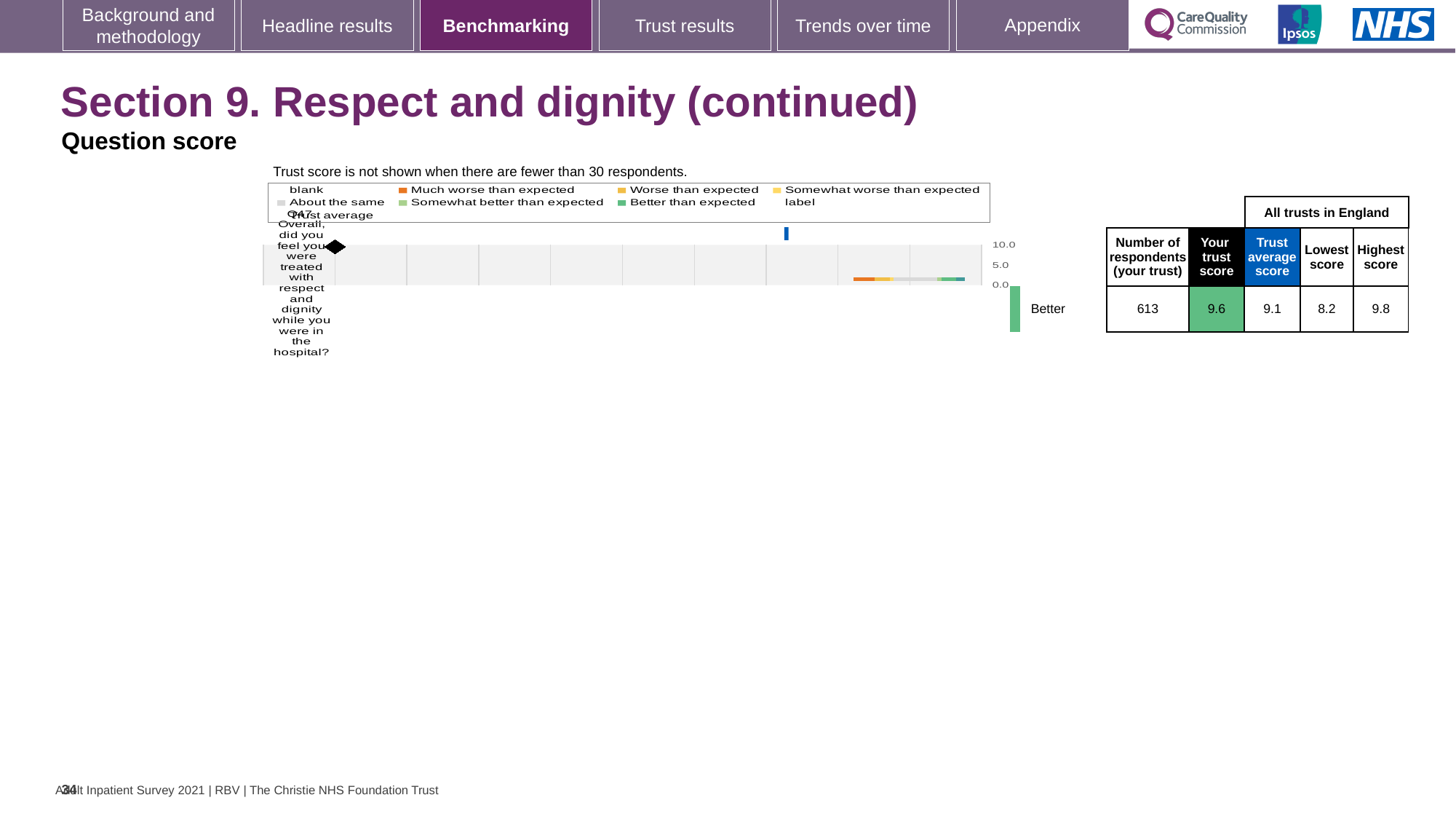
What is the 'Trust average score' for all trusts in England shown for Q47? 9.1 What is the highest value shown on the chart's vertical axis? 10.0 Is your trust score for Q47 greater or less than 5.0 on the chart's axis? greater What word is printed next to the green bar to the right of the chart's axis? Better How many respondents from your trust are shown for Q47? 613 By how much does your trust score (9.6) exceed the trust average score (9.1) for Q47? 0.5 What is the 'Highest score' among all trusts in England shown for Q47? 9.8 What is the 'Your trust score' value shown for Q47 (Overall, did you feel you were treated with respect and dignity while you were in the hospital?)? 9.6 What kind of chart is used to show the Q47 question score? Bar chart What is the difference between the highest score (9.8) and the lowest score (8.2) for Q47? 1.6 What is the 'Lowest score' among all trusts in England shown for Q47? 8.2 Which is larger for Q47: your trust score or the trust average score? Your trust score